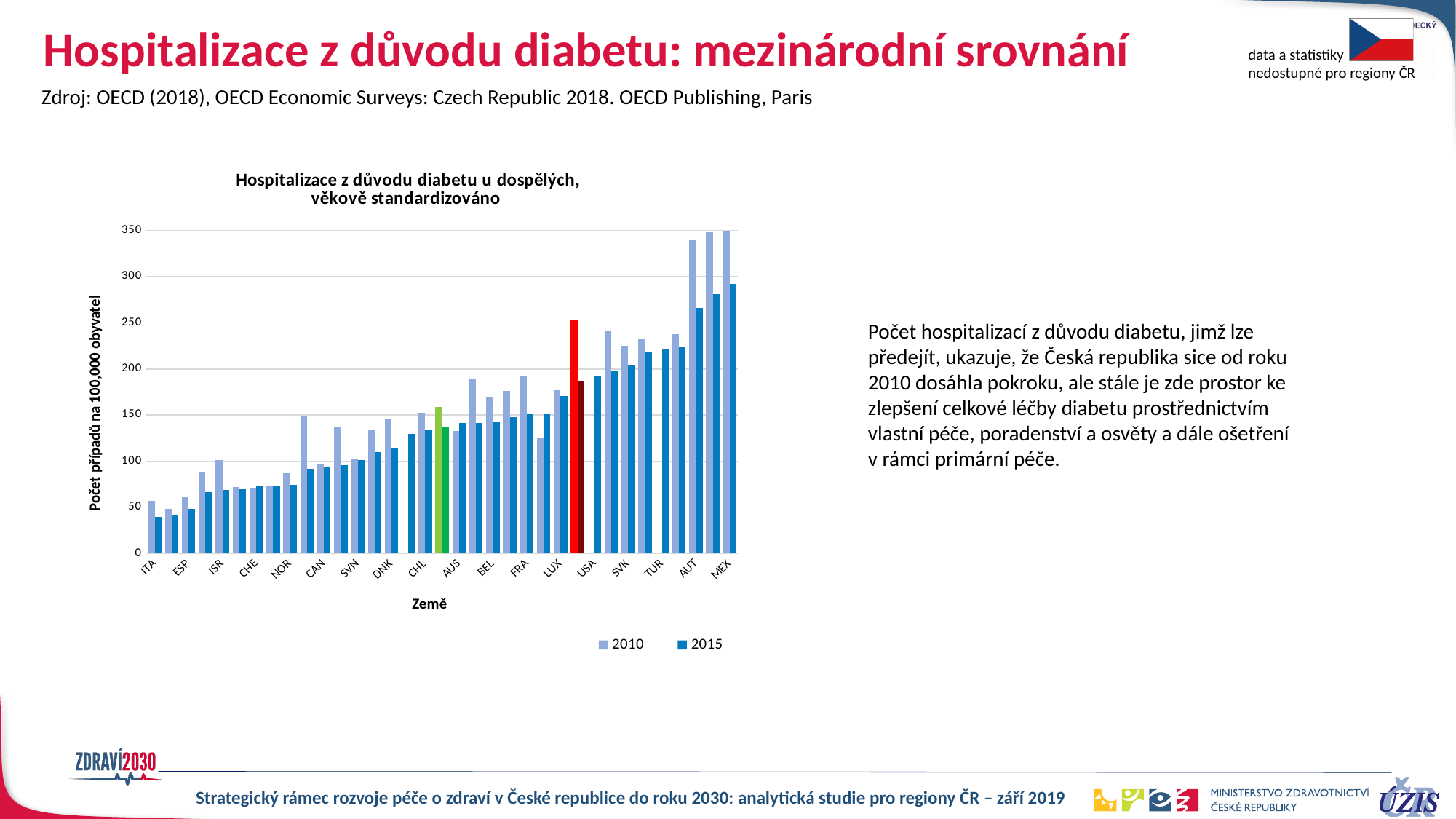
For AUT, which is larger: the 2010 value or the 2015 value? 2010 Is the 2015 value for TUR greater or less than 200? greater What is the title of the chart's vertical axis? Počet případů na 100,000 obyvatel Which country has the highest 2010 value in the chart? MEX What kind of chart is shown on the slide? bar chart Is the 2015 value for MEX greater or less than 300? less Which country has the lowest 2015 value in the chart? ITA Do the values generally rise or fall from left to right along the x axis? rise How many series does the chart legend list? 2 Is the 2010 value for AUT greater or less than 300? greater Which series are listed in the chart legend? 2010 and 2015